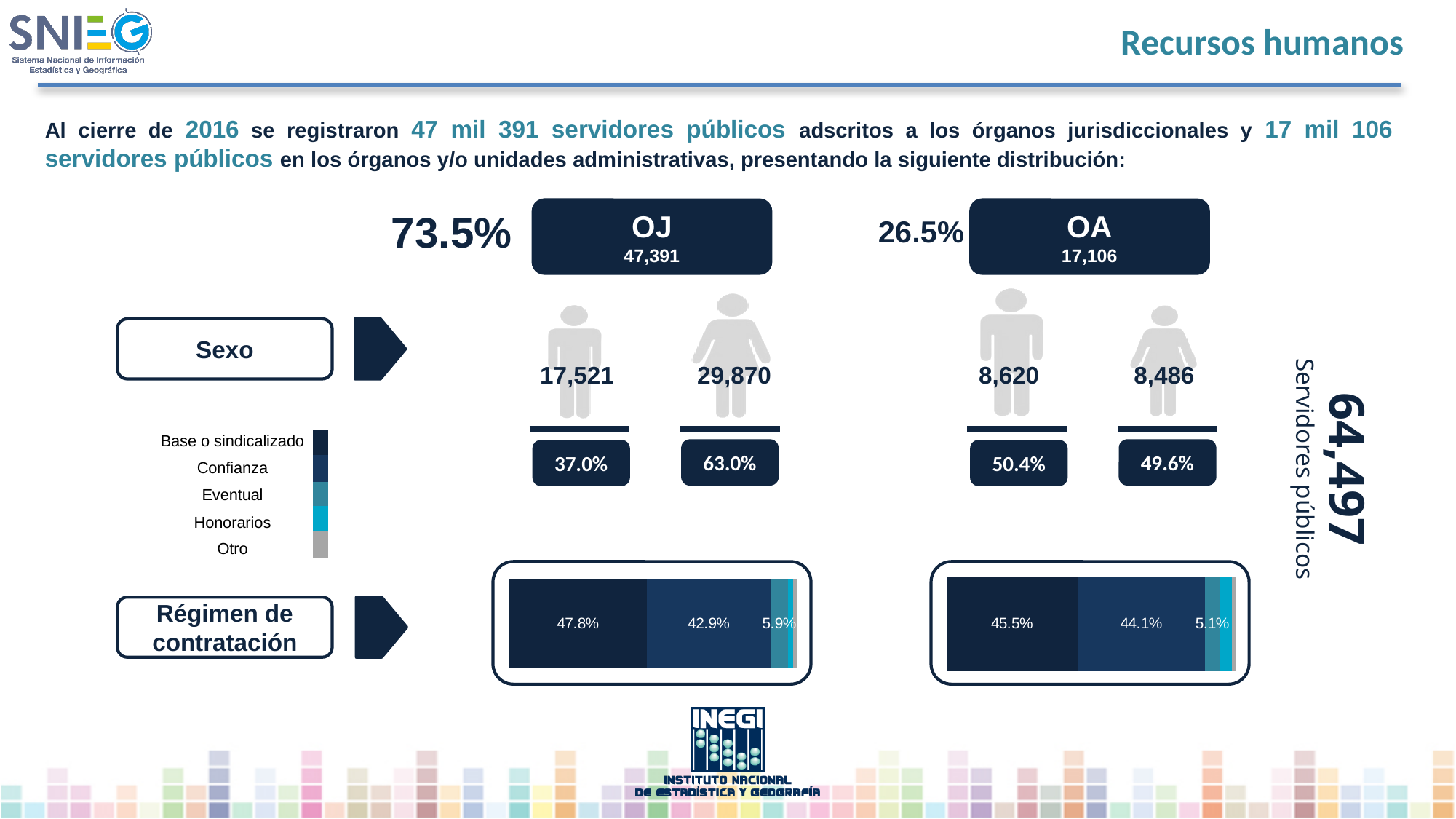
In the OJ 'Régimen de contratación' bar, what is the difference between the Base o sindicalizado and Confianza shares? 4.9 percentage points In the OJ 'Régimen de contratación' bar, what is the value for Eventual? 5.9% In the OJ 'Régimen de contratación' bar, what is the value for Confianza? 42.9% How many categories does the legend for the 'Régimen de contratación' bars list? 5 In the OA 'Régimen de contratación' bar, what is the value for Confianza? 44.1% What colour represents 'Otro' in the 'Régimen de contratación' legend? grey Which has a larger share of Base o sindicalizado in the 'Régimen de contratación' bars, OJ or OA? OJ In the OJ 'Régimen de contratación' bar, what is the value for Base o sindicalizado? 47.8% In the OA 'Régimen de contratación' bar, what is the value for Eventual? 5.1% In the OA 'Régimen de contratación' bar, what is the value for Base o sindicalizado? 45.5% What kind of chart is used for the 'Régimen de contratación' section? bar chart In the OJ 'Régimen de contratación' bar, which category has the largest share? Base o sindicalizado